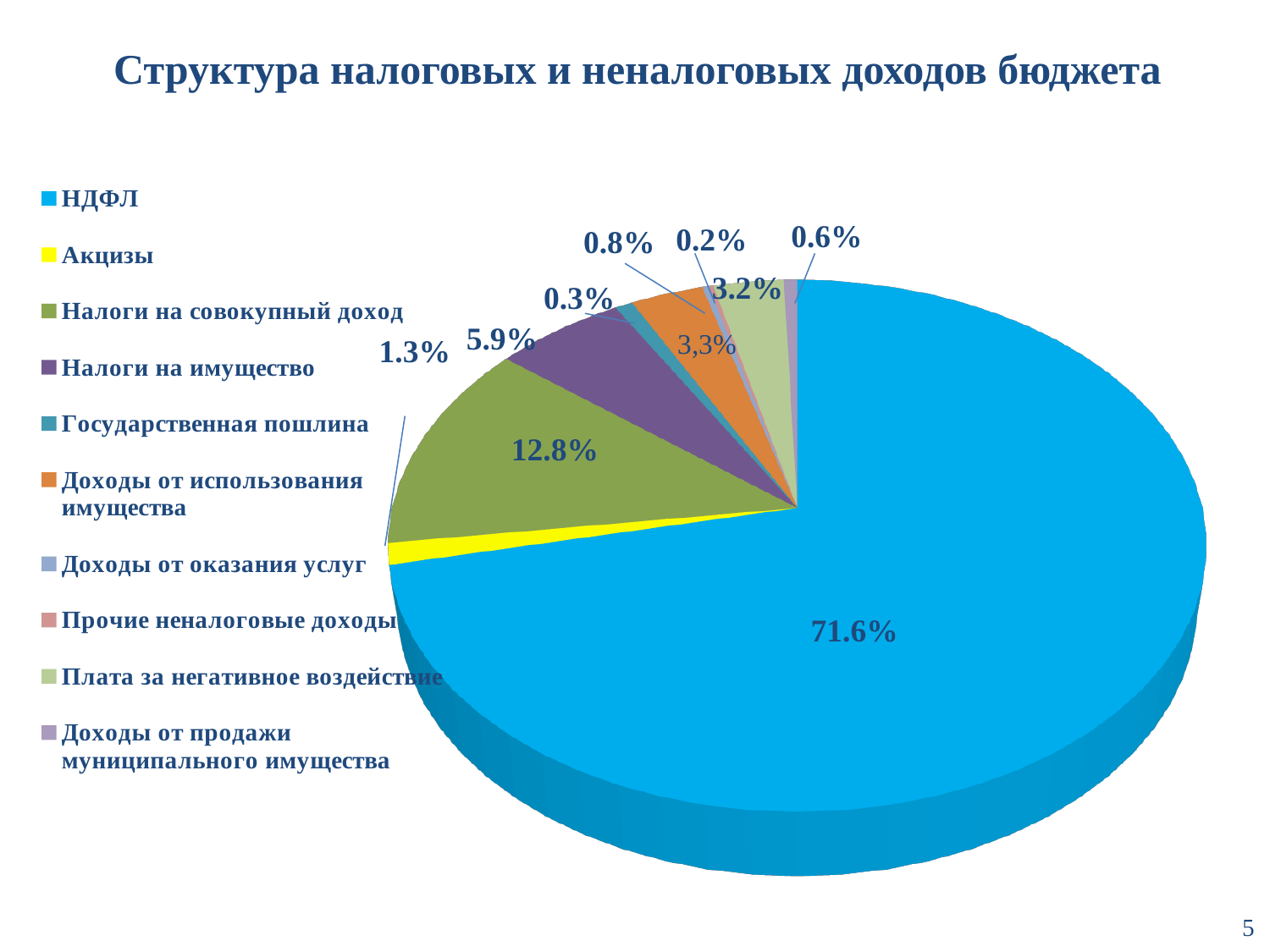
Which category has the largest share of the pie? НДФЛ What colour is the НДФЛ slice? Blue What share of the pie does Налоги на совокупный доход have? 12.8% What share of the pie does Акцизы have? 1.3% What share of the pie does Плата за негативное воздействие have? 3.2% Which is larger: the share for Налоги на совокупный доход or the share for Налоги на имущество? Налоги на совокупный доход What is the title of the chart? Структура налоговых и неналоговых доходов бюджета How many categories does the legend list? 10 What is the difference in percentage points between the share for НДФЛ and the share for Налоги на совокупный доход? 58.8 What share of the pie does НДФЛ have? 71.6% What kind of chart is shown on the slide? Pie chart What share of the pie does Налоги на имущество have? 5.9%